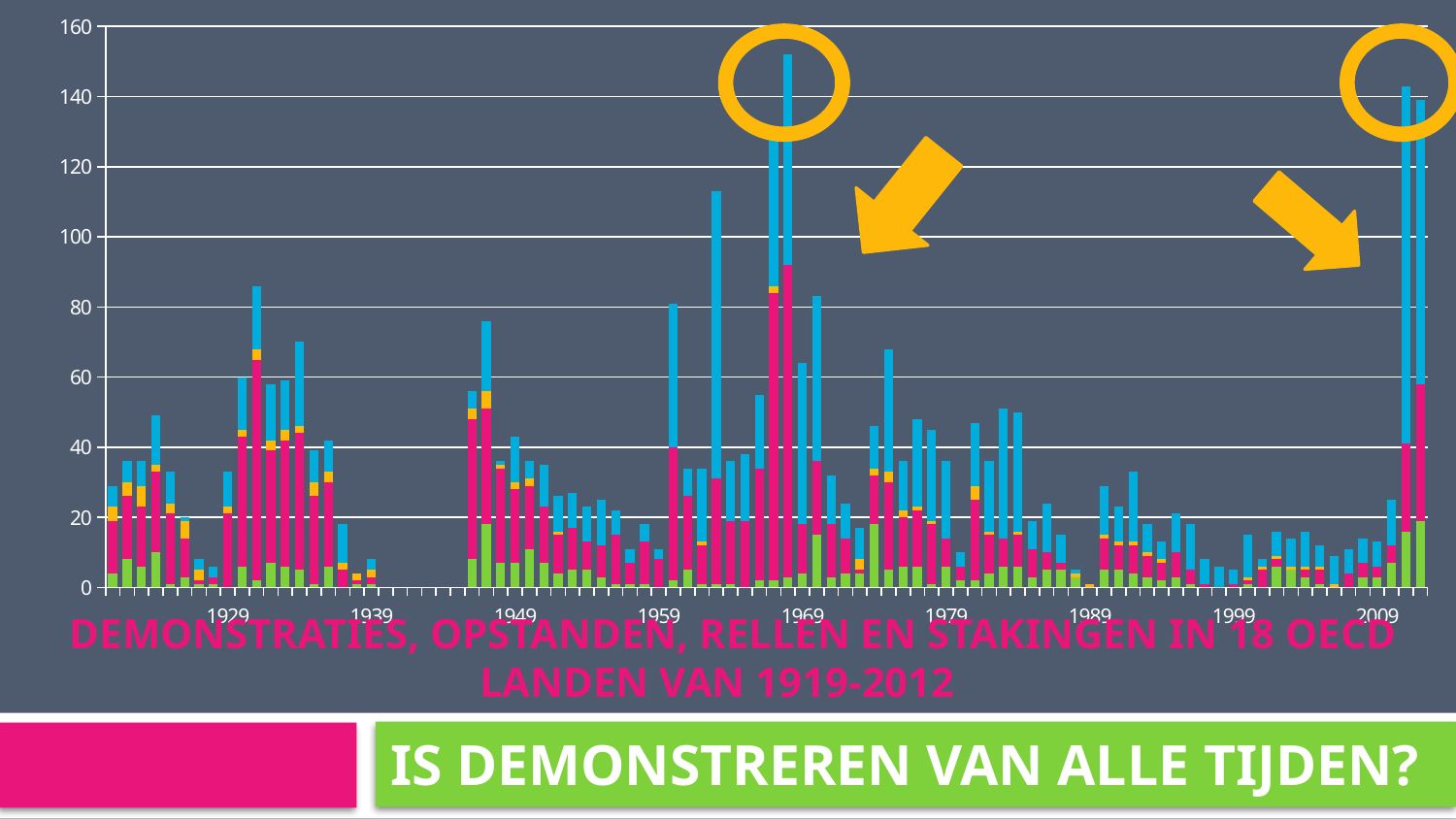
Is the tallest bar in the chart greater or less than 140? greater Is the tallest bar near the right end of the chart (around 2011) greater or less than 120? greater Is the tallest bar in the 1930s greater or less than 100? less How many year labels are shown on the horizontal axis? 9 What is the highest value shown on the vertical axis? 160 What is the last year label shown on the horizontal axis? 2009 What is the title of the chart? DEMONSTRATIES, OPSTANDEN, RELLEN EN STAKINGEN IN 18 OECD LANDEN VAN 1919-2012 What is the first year label shown on the horizontal axis? 1929 What kind of chart is shown on the slide? Stacked bar chart Which is taller: the tallest bar around 1968 or the tallest bar around 2011? The bar around 1968